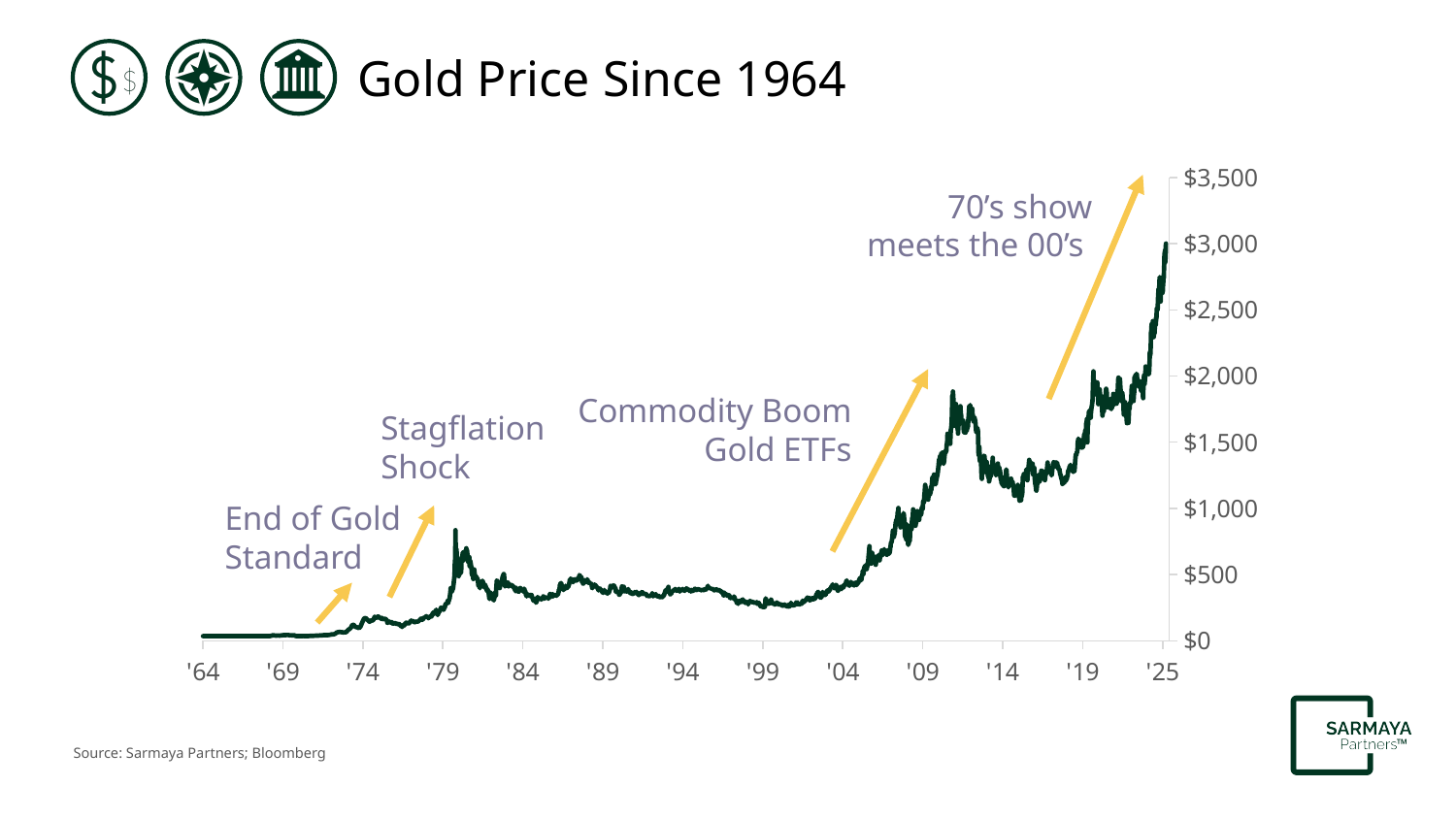
Is the gold price at '14 greater or less than $1,000? greater In which year shown on the x axis is the gold price highest? '25 Is the gold price at '64 greater or less than $500? less Is the gold price at '99 greater or less than $500? less What kind of chart is shown on the slide? line chart In which year shown on the x axis is the gold price lowest? '64 Is the gold price at '25 larger or smaller than the gold price at '09? larger Overall, does the gold price rise or fall from '64 to '25? rise What is the highest value shown on the y axis? $3,500 What is the title of the chart? Gold Price Since 1964